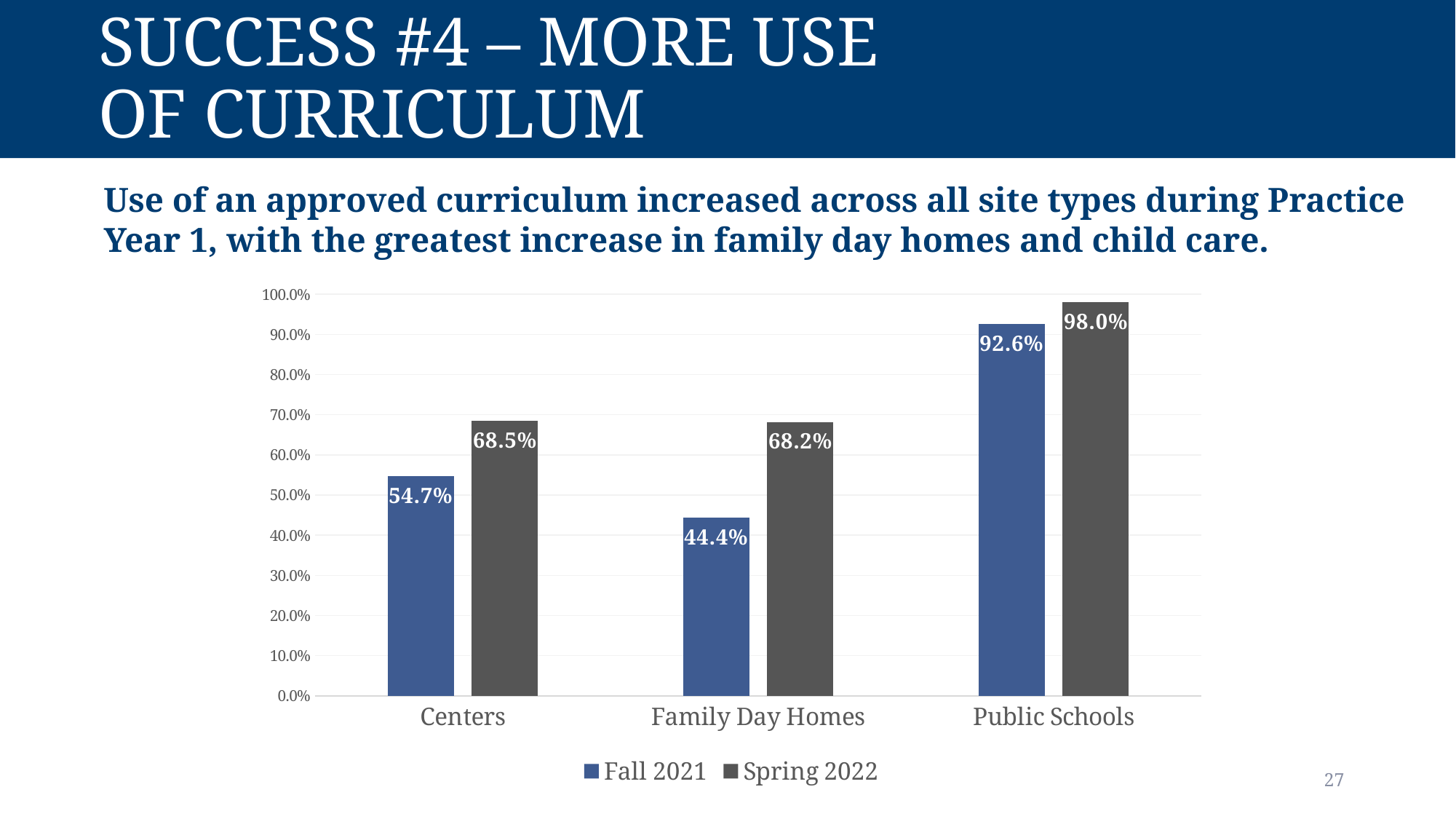
What is the difference between the Spring 2022 and Fall 2021 values for Family Day Homes? 23.8% How many site types are shown on the x axis? 3 What is the difference between the Spring 2022 and Fall 2021 values for Public Schools? 5.4% What is the Spring 2022 value for Public Schools? 98.0% Which is larger: the Fall 2021 value for Centers or the Fall 2021 value for Family Day Homes? Centers What is the Fall 2021 value for Centers? 54.7% What is the Spring 2022 value for Family Day Homes? 68.2% Which site type has the highest Spring 2022 value? Public Schools How many series does the legend list? 2 What kind of chart is shown on the slide? Bar chart Which site type has the lowest Fall 2021 value? Family Day Homes Which series is shown in dark grey in the legend? Spring 2022